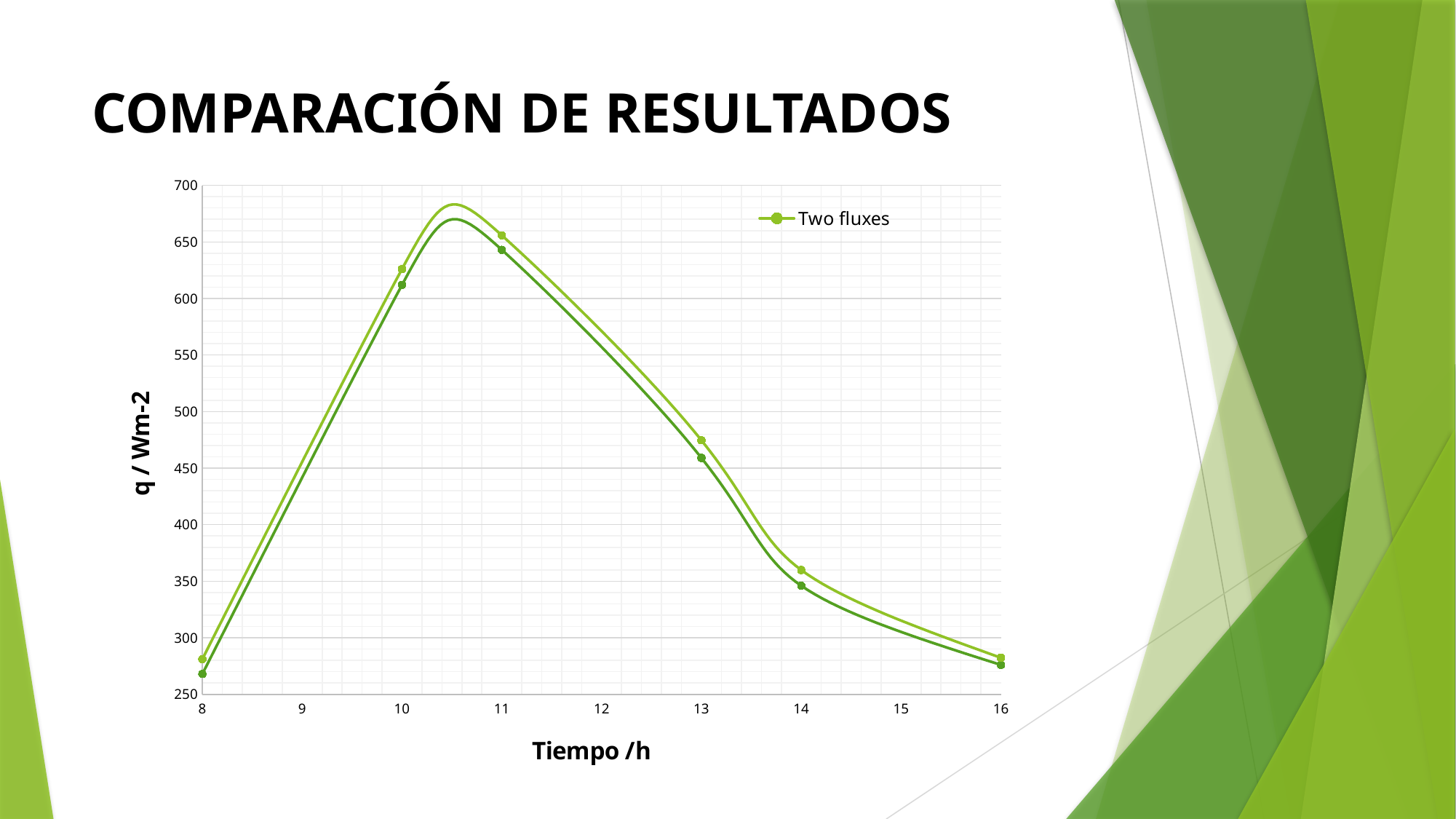
Is the value of Two fluxes at Tiempo 16 h greater or less than 300? less Is the value of Two fluxes at Tiempo 8 h greater or less than 300? less What kind of chart is shown on the slide? line chart How many data points are marked on the Two fluxes line? 6 How many series does the chart legend list? 1 Is the value of Two fluxes at Tiempo 10 h greater or less than 600? greater At which Tiempo value does the Two fluxes series reach its highest marked point? 11 Which is larger for Two fluxes: the value at Tiempo 10 h or at Tiempo 13 h? Tiempo 10 h Do the Two fluxes values rise or fall between Tiempo 11 h and Tiempo 16 h? fall What is the name of the series listed in the legend? Two fluxes What is the title of the slide containing the chart? COMPARACIÓN DE RESULTADOS